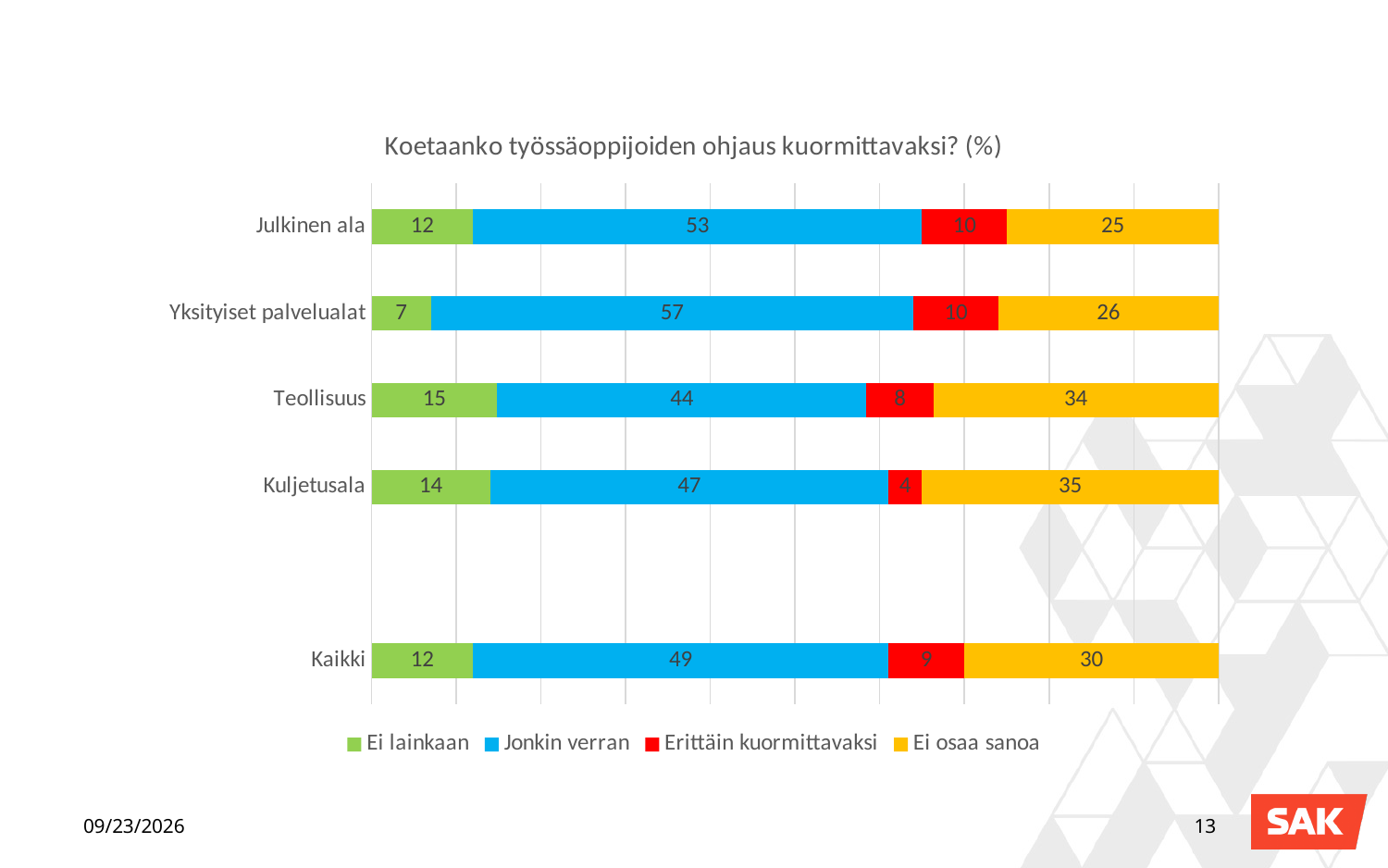
Which is larger: the "Ei lainkaan" value for Teollisuus or for Kuljetusala? Teollisuus What is the total of the stacked bar for Kaikki? 100 What is the value of "Ei osaa sanoa" for Teollisuus? 34 Which category has the lowest value for "Ei lainkaan"? Yksityiset palvelualat How many categories are shown on the y axis? 5 Which category has the highest value for "Jonkin verran"? Yksityiset palvelualat What kind of chart is shown? Stacked bar chart What is the value of "Jonkin verran" for Julkinen ala? 53 How many series does the legend list? 4 What is the value of "Erittäin kuormittavaksi" for Kuljetusala? 4 What is the value of "Ei lainkaan" for Yksityiset palvelualat? 7 What is the difference between the "Ei osaa sanoa" values for Kuljetusala and Julkinen ala? 10